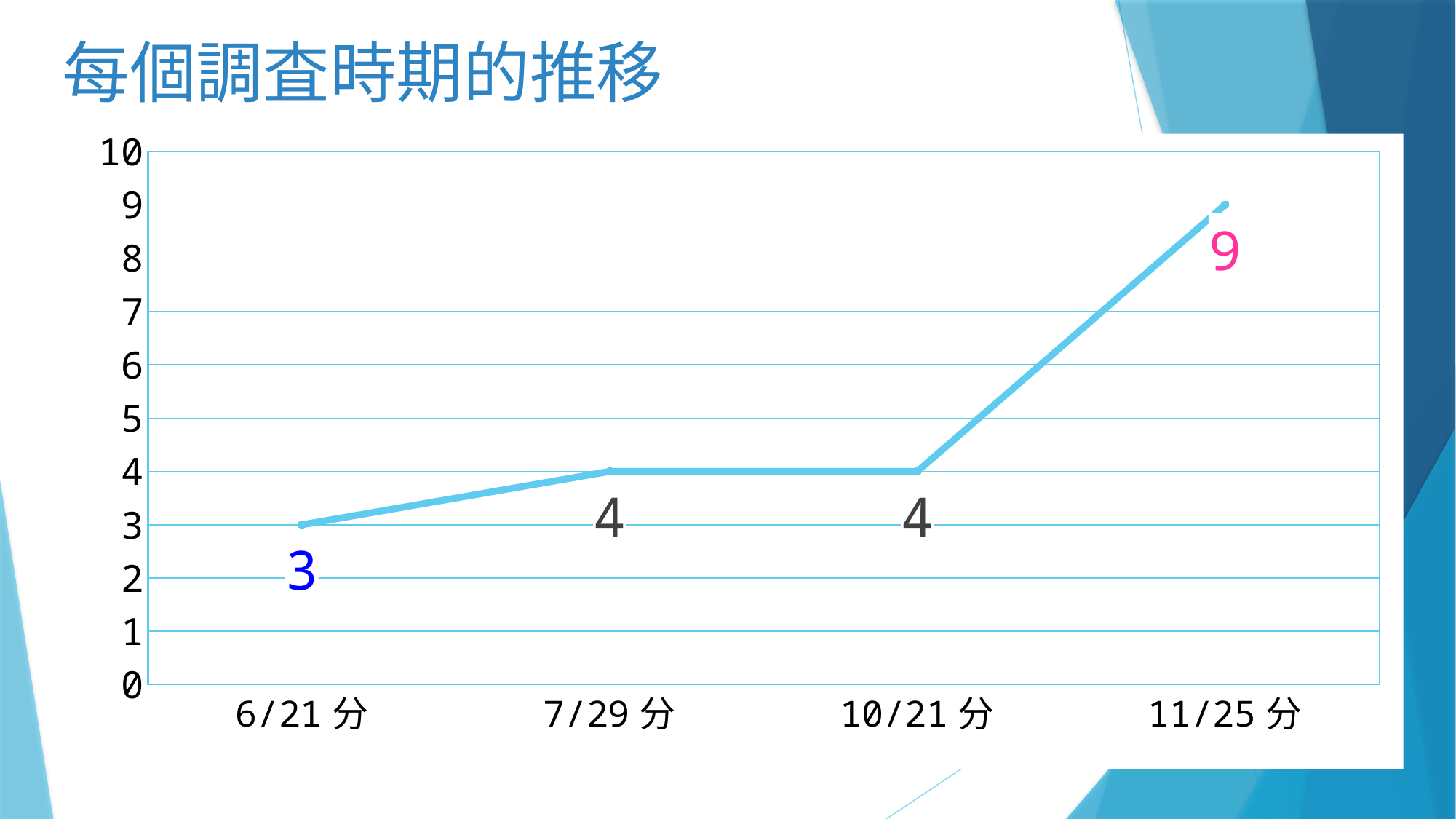
What is the value for 6/21 分? 3 Which category has the highest value? 11/25 分 What is the difference between the values for 7/29 分 and 6/21 分? 1 Which is larger, the value for 11/25 分 or the value for 6/21 分? 11/25 分 How many data points are plotted on the chart? 4 What kind of chart is shown on the slide? Line chart Which category has the lowest value? 6/21 分 What is the value for 10/21 分? 4 What is the value for 7/29 分? 4 What is the difference between the values for 11/25 分 and 10/21 分? 5 Do the values rise or fall from 6/21 分 to 11/25 分? Rise What is the value for 11/25 分? 9